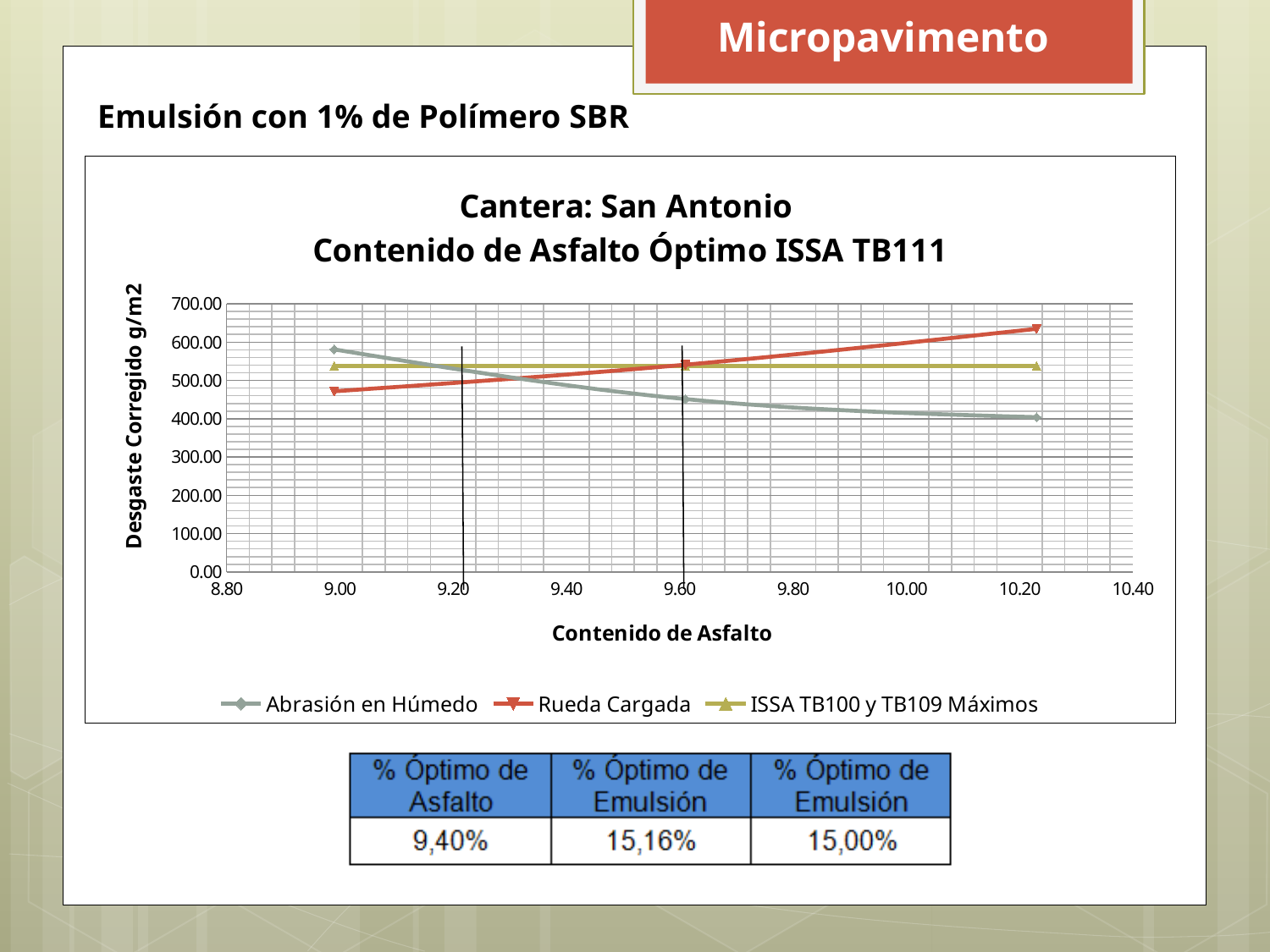
How many series does the chart legend list? 3 Is the Rueda Cargada value at Contenido de Asfalto 9.00 greater or less than 500.00? less At Contenido de Asfalto 9.00, which series has the higher value, Abrasión en Húmedo or Rueda Cargada? Abrasión en Húmedo Is the Abrasión en Húmedo value at Contenido de Asfalto 9.00 greater or less than 500.00? greater What kind of chart is shown on the slide? line chart Does the Rueda Cargada series rise or fall as Contenido de Asfalto increases? rise What is the label of the vertical axis of the chart? Desgaste Corregido g/m2 How many data points does the Abrasión en Húmedo series have? 3 At the rightmost point (near 10.20), which series has the higher value, Abrasión en Húmedo or Rueda Cargada? Rueda Cargada Does the Abrasión en Húmedo series rise or fall as Contenido de Asfalto increases? fall Is the Rueda Cargada value at its rightmost point (near 10.20) greater or less than 600.00? greater